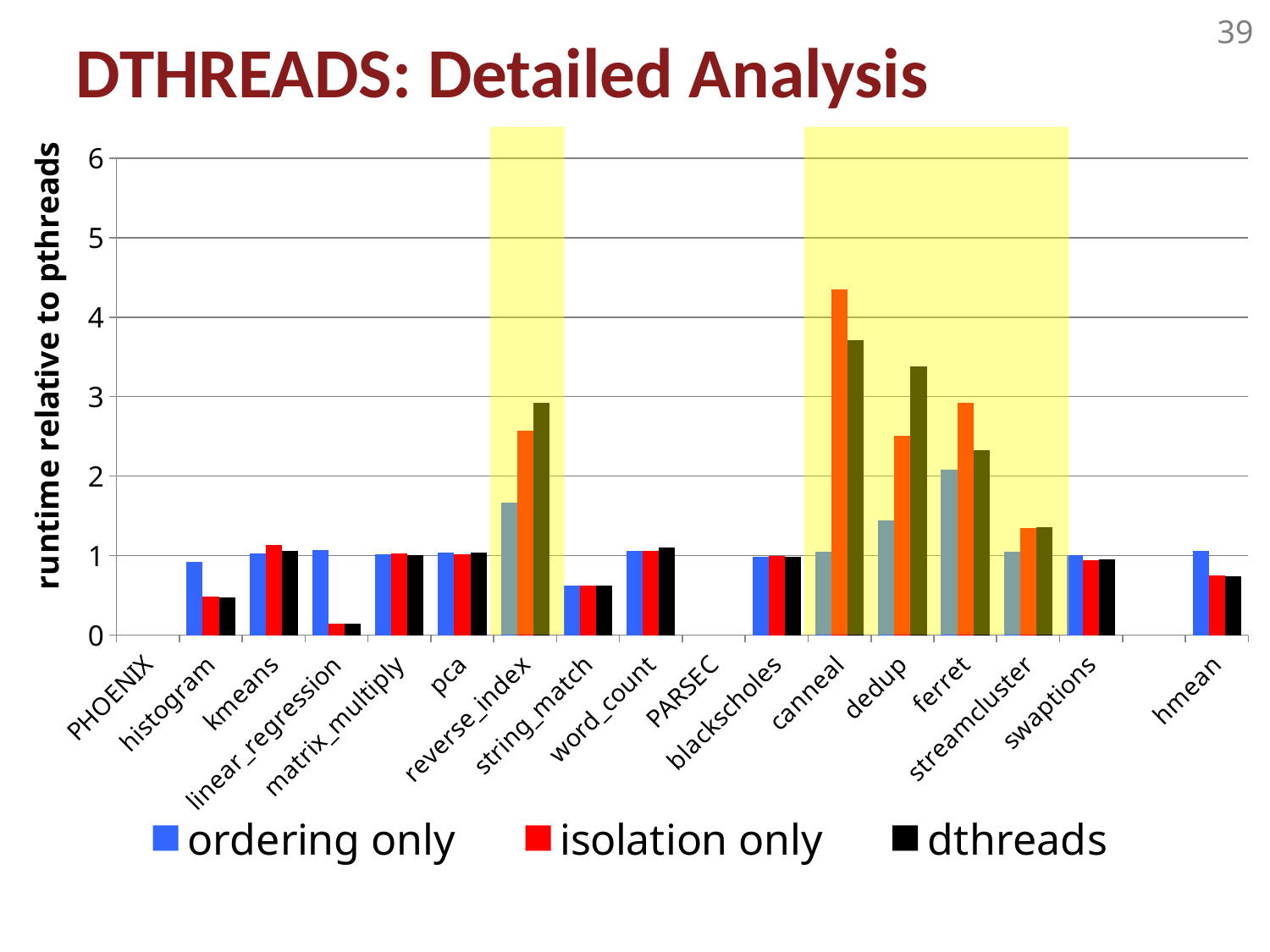
How many series does the legend list? 3 Which benchmark has the lowest 'isolation only' value? linear_regression Is the 'isolation only' value for canneal greater or less than 4? greater Which colour represents the 'ordering only' series in the legend? blue Is the 'dthreads' value for dedup greater or less than 3? greater Is the 'dthreads' value for histogram greater or less than 1? less For dedup, which is larger: the 'isolation only' value or the 'dthreads' value? dthreads What kind of chart is shown on the slide? bar chart Which benchmark has the highest 'isolation only' value? canneal What is the y-axis title of the chart? runtime relative to pthreads